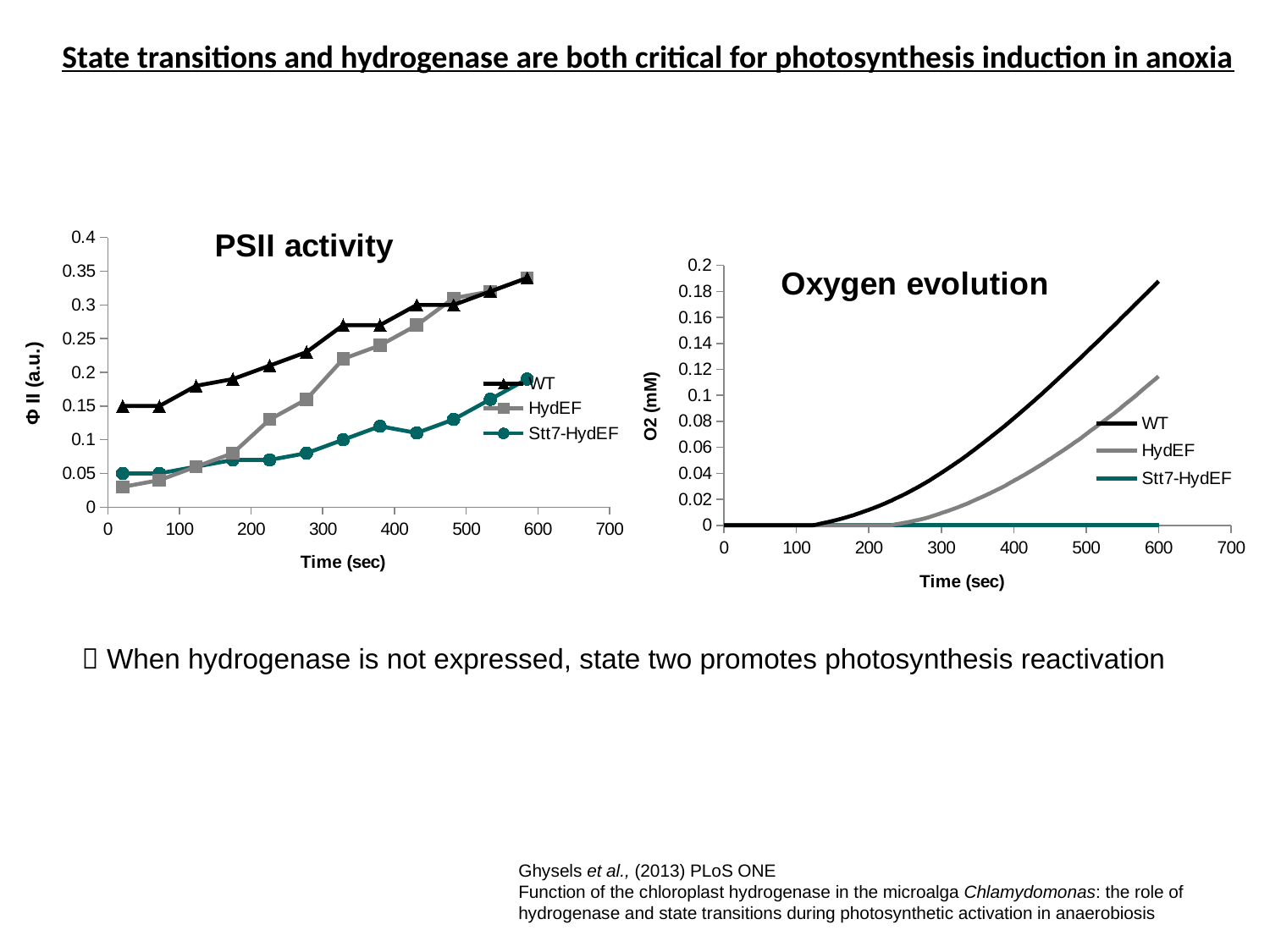
How many series does the legend of the Oxygen evolution chart list? 3 What kind of chart is the PSII activity chart? line chart What is the y-axis label of the Oxygen evolution chart? O2 (mM) In the PSII activity chart, is the value for Stt7-HydEF at about 600 sec greater or less than 0.25? less In the Oxygen evolution chart, is the value for HydEF at 600 sec greater or less than 0.1? greater What is the title of the chart on the right of the slide? Oxygen evolution In the Oxygen evolution chart, which series is higher at 600 sec, WT or HydEF? WT In the PSII activity chart, is the value for WT at about 600 sec greater or less than 0.3? greater In the Oxygen evolution chart, which series has the lowest values? Stt7-HydEF In the Oxygen evolution chart, which series reaches the highest value? WT In the Oxygen evolution chart, do the WT values rise or fall over time? rise How many series does the legend of the PSII activity chart list? 3